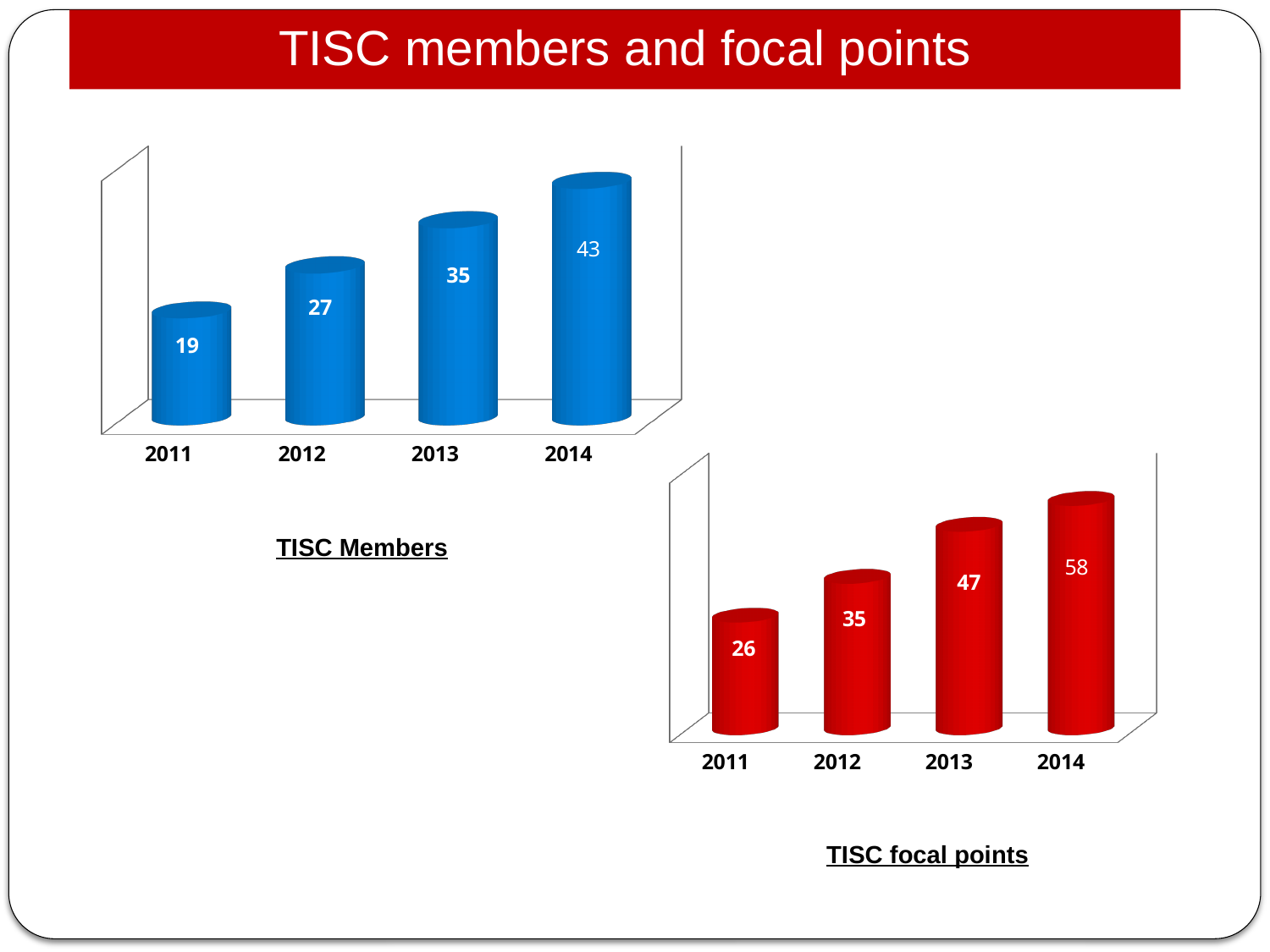
In the TISC focal points chart, do the values rise or fall from 2011 to 2014? Rise In the TISC Members chart, what is the value for 2011? 19 In the TISC Members chart, which year has the highest value? 2014 What kind of chart is the TISC Members chart? Bar chart In the TISC focal points chart, which year has the lowest value? 2011 In the TISC focal points chart, what is the value for 2012? 35 How many years are shown in the TISC focal points chart? 4 Which is larger: the 2013 value in the TISC Members chart or the 2013 value in the TISC focal points chart? TISC focal points In the TISC focal points chart, what is the difference between the values for 2014 and 2011? 32 In the TISC Members chart, what is the difference between the values for 2013 and 2012? 8 In the TISC focal points chart, what is the value for 2013? 47 In the TISC Members chart, what is the value for 2014? 43